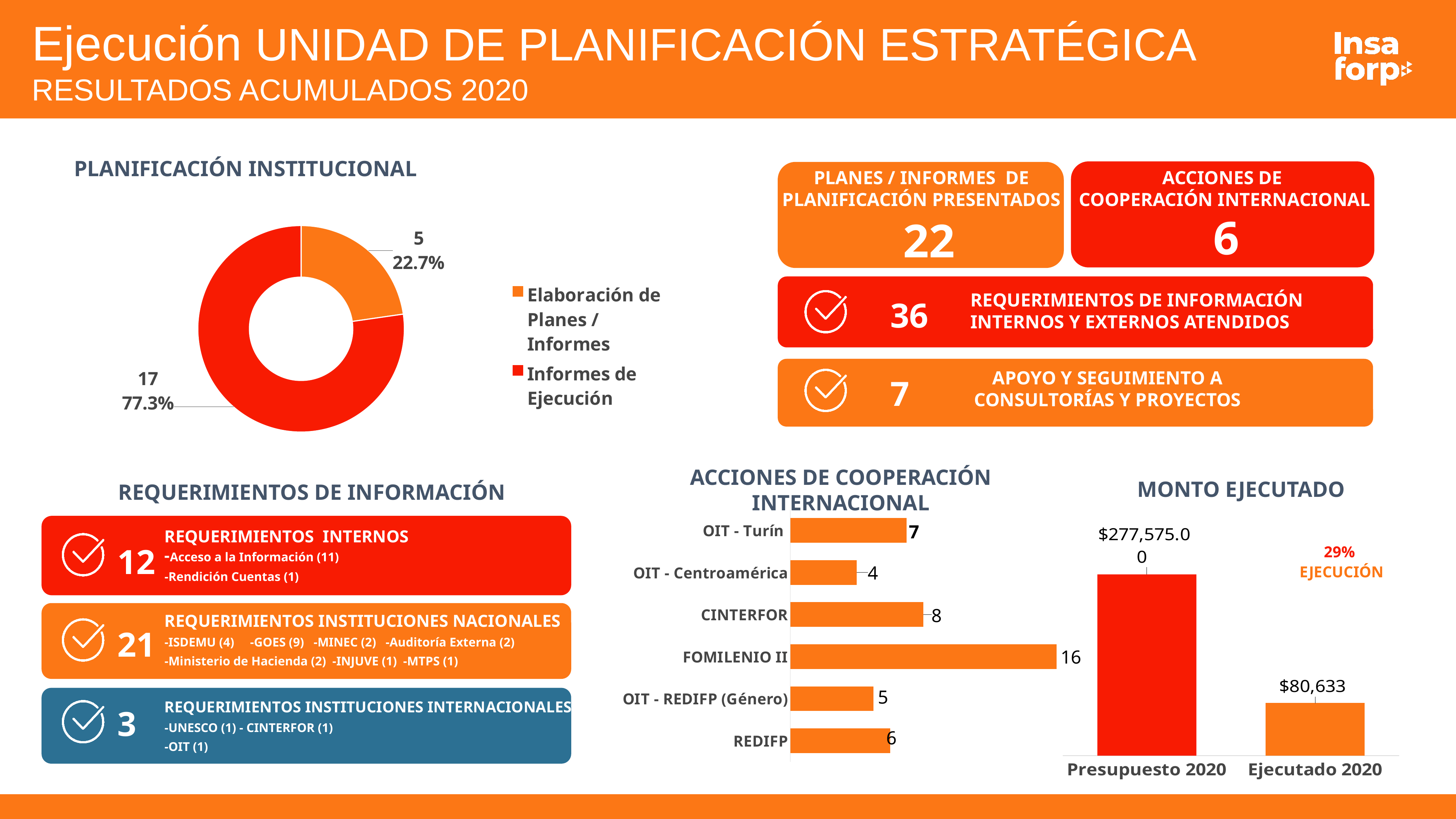
In the ACCIONES DE COOPERACIÓN INTERNACIONAL chart, which category has the lowest value? OIT - Centroamérica What kind of chart is the ACCIONES DE COOPERACIÓN INTERNACIONAL chart? Bar chart In the PLANIFICACIÓN INSTITUCIONAL chart, what share of the total is Elaboración de Planes / Informes? 22.7% In the ACCIONES DE COOPERACIÓN INTERNACIONAL chart, what is the difference between CINTERFOR and OIT - REDIFP (Género)? 3 In the ACCIONES DE COOPERACIÓN INTERNACIONAL chart, what is the value for FOMILENIO II? 16 What kind of chart is the PLANIFICACIÓN INSTITUCIONAL chart? Donut (pie) chart How many categories are shown in the ACCIONES DE COOPERACIÓN INTERNACIONAL chart? 6 In the MONTO EJECUTADO chart, what is the value for Ejecutado 2020? $80,633 In the ACCIONES DE COOPERACIÓN INTERNACIONAL chart, which category has the highest value? FOMILENIO II In the MONTO EJECUTADO chart, which is larger, Presupuesto 2020 or Ejecutado 2020? Presupuesto 2020 How many entries does the legend of the PLANIFICACIÓN INSTITUCIONAL chart list? 2 In the PLANIFICACIÓN INSTITUCIONAL chart, what value is shown for Informes de Ejecución? 17